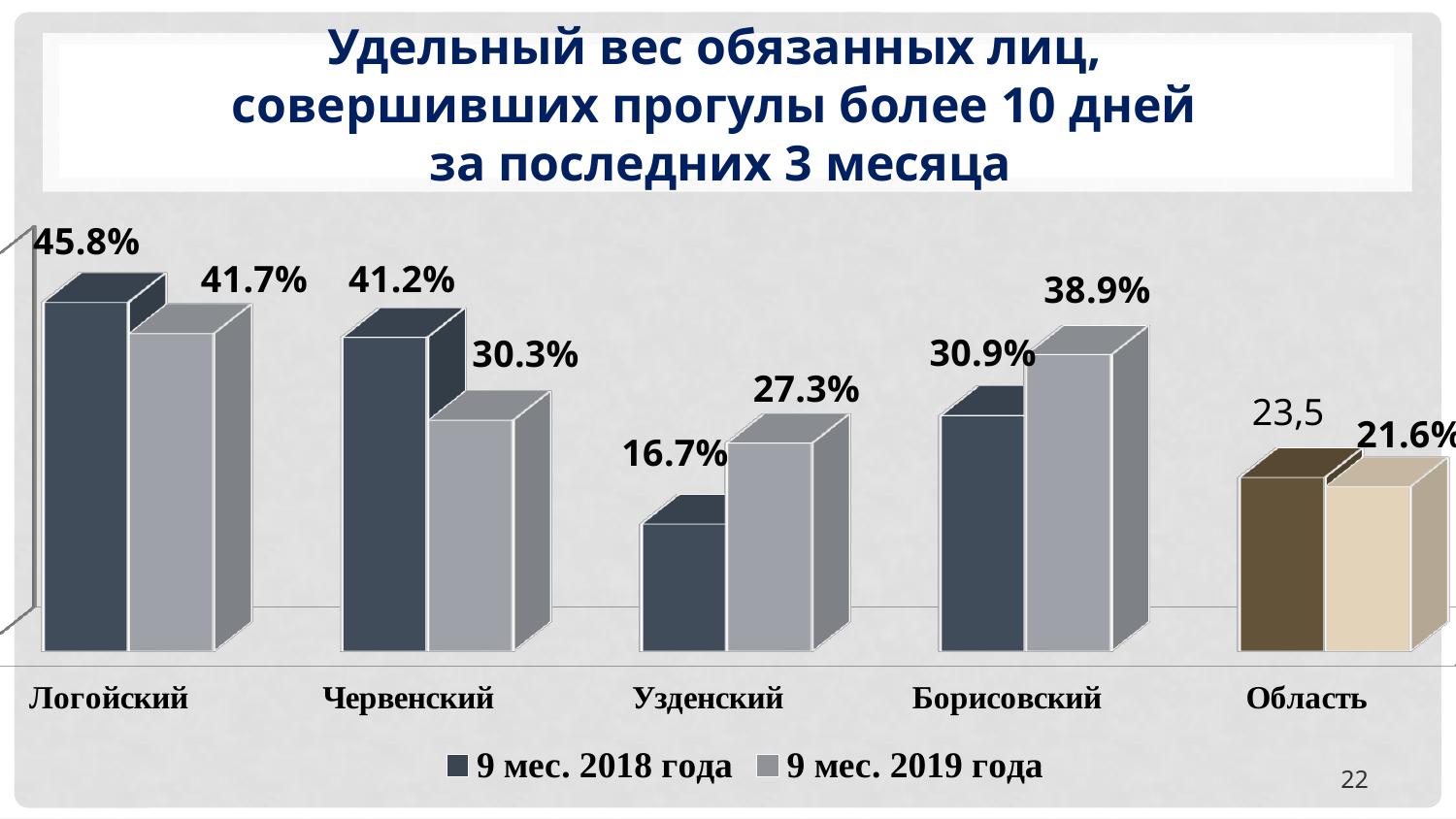
What is the value for Борисовский in the series 9 мес. 2019 года? 38.9% What kind of chart is shown on the slide? Bar chart What is the value for Логойский in the series 9 мес. 2018 года? 45.8% What is the difference between the 9 мес. 2018 года and 9 мес. 2019 года values for Червенский? 10.9% What is the value for Узденский in the series 9 мес. 2019 года? 27.3% For Узденский, which series has the larger value: 9 мес. 2018 года or 9 мес. 2019 года? 9 мес. 2019 года What is the value for Область in the series 9 мес. 2018 года? 23,5 Which category has the lowest value in the series 9 мес. 2019 года? Область Which category has the highest value in the series 9 мес. 2018 года? Логойский How many categories are shown on the x axis? 5 How many series does the legend list? 2 What is the difference between the 9 мес. 2019 года values for Борисовский and Узденский? 11.6%